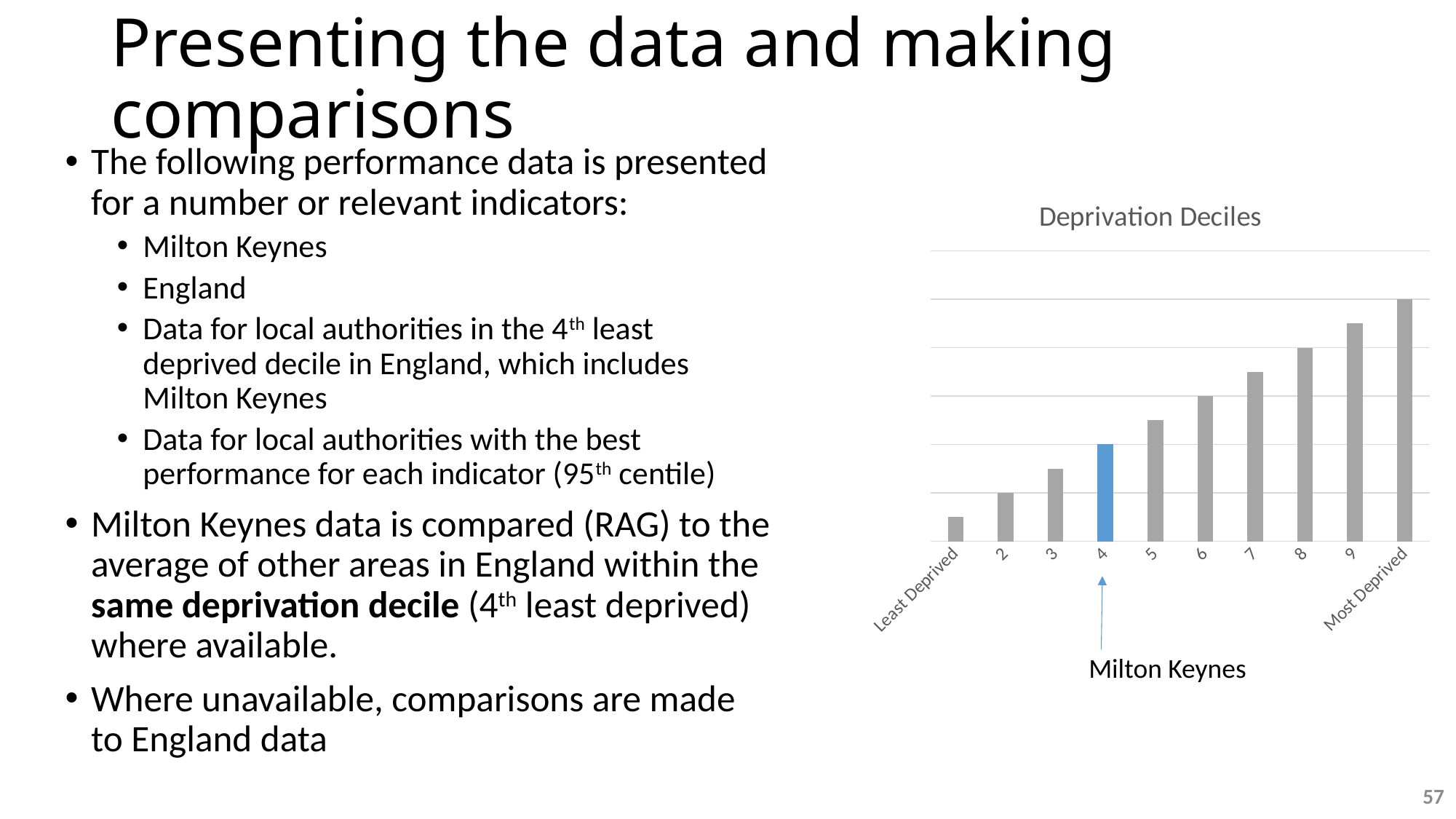
Which category has the highest bar in the Deprivation Deciles chart? Most Deprived Which bar is taller, decile 2 or decile 9? 9 Which bar is taller, decile 7 or decile 3? 7 Which category has the lowest bar in the Deprivation Deciles chart? Least Deprived What kind of chart is shown on the slide? Bar chart Is the bar for decile 5 taller or shorter than the bar for decile 8? Shorter What is the title of the chart? Deprivation Deciles How many categories (bars) are shown in the Deprivation Deciles chart? 10 Do the bars rise or fall moving from Least Deprived to Most Deprived along the x axis? Rise Which decile's bar is highlighted in blue in the Deprivation Deciles chart? 4